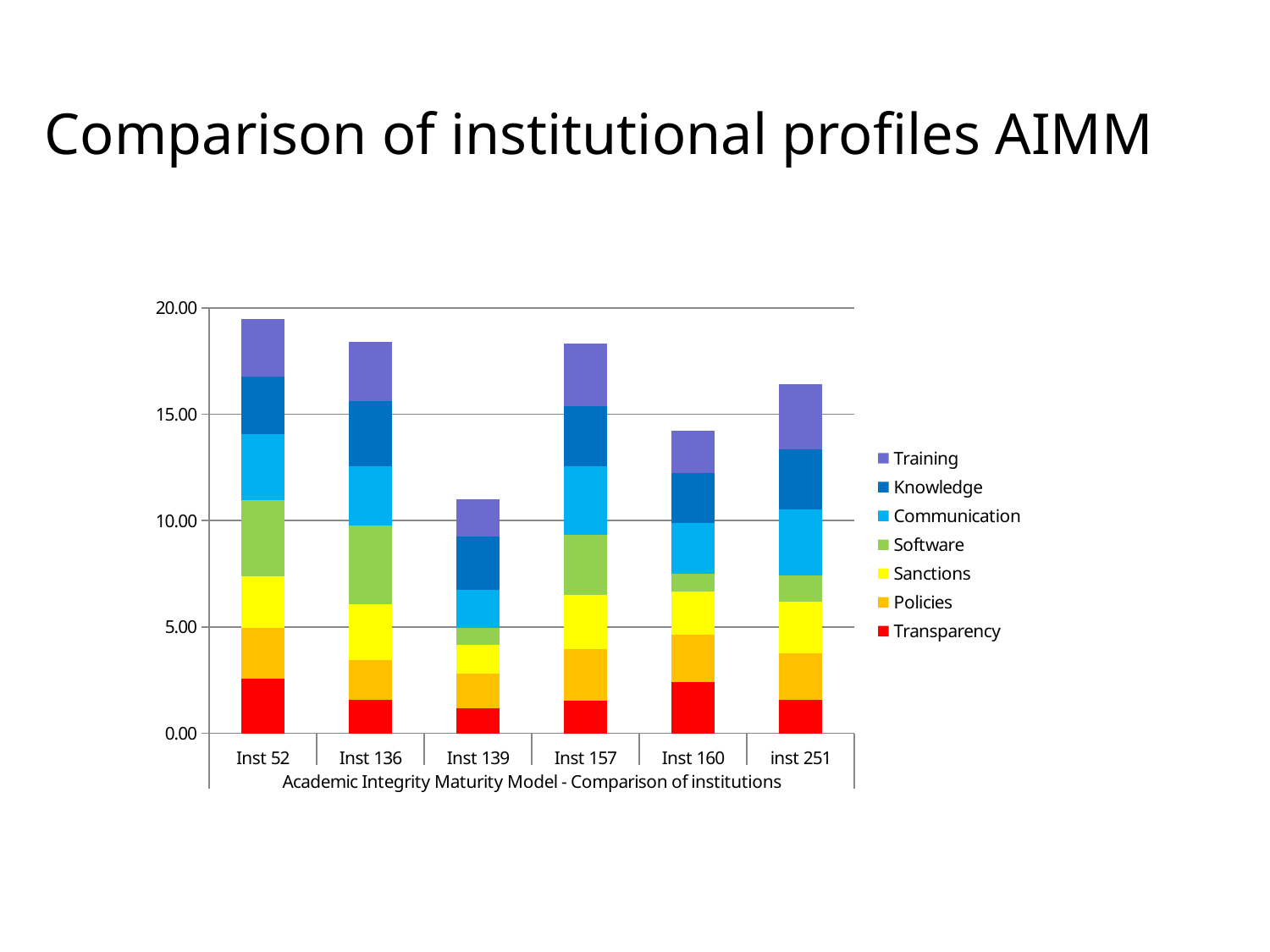
What kind of chart is shown on the slide? Stacked bar chart Is the total stacked value for Inst 160 greater or less than 15.00? less How many series does the chart's legend list? 7 What is the axis title shown below the institution labels? Academic Integrity Maturity Model - Comparison of institutions Is the total stacked value for inst 251 greater or less than 15.00? greater How many institutions are shown on the x axis of the chart? 6 Which institution has the shortest stacked bar overall? Inst 139 Which series is shown in red at the bottom of each stacked bar? Transparency Is the total stacked value for Inst 52 greater or less than 15.00? greater Which institution has the tallest stacked bar overall? Inst 52 Which has the larger total stacked bar, Inst 139 or Inst 160? Inst 160